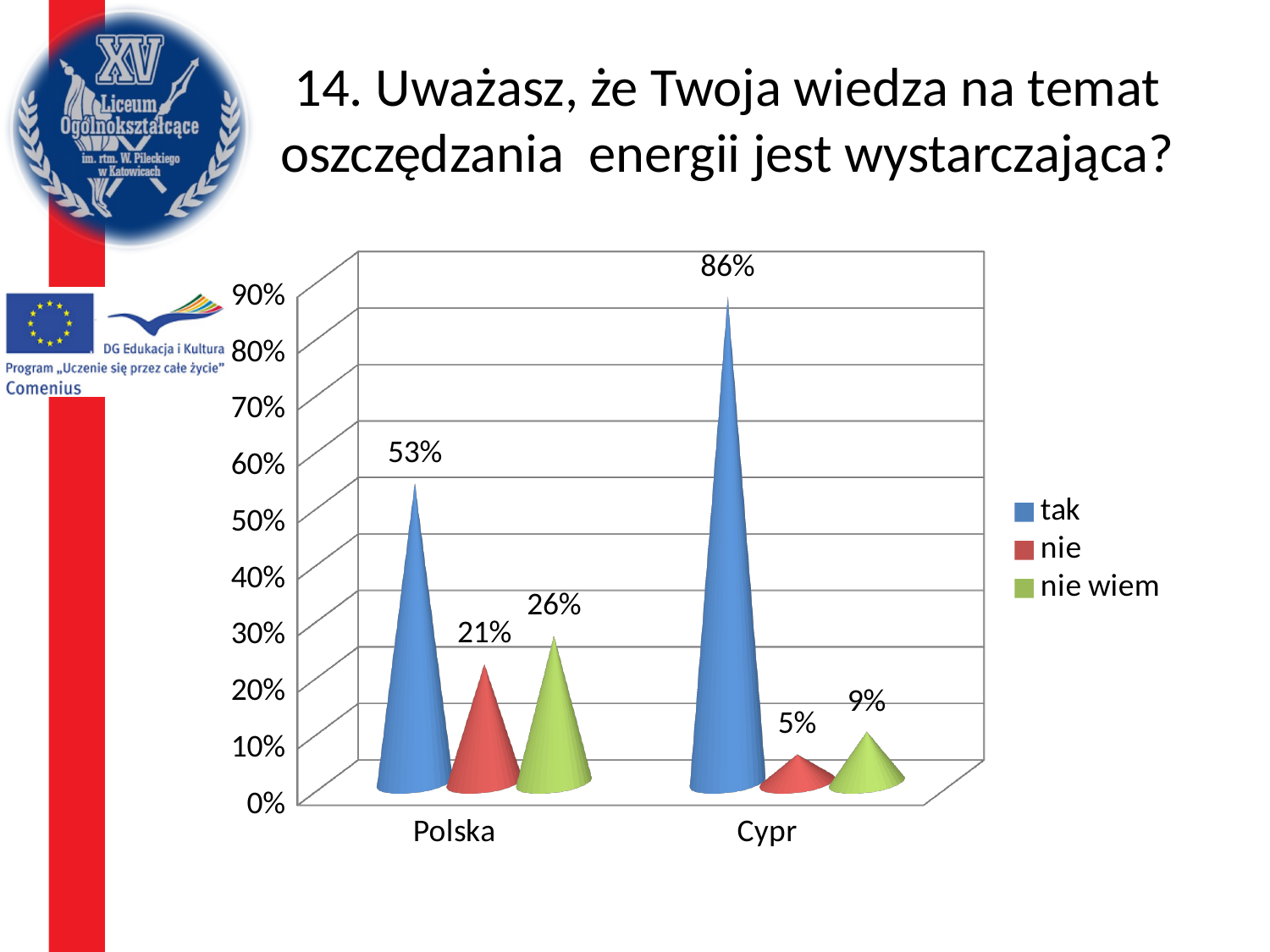
How many series does the legend list? 3 What is the value for "tak" for Cypr? 86% How many countries are shown on the x axis? 2 What is the difference between the "tak" values for Cypr and Polska? 33% What is the value for "tak" for Polska? 53% Which is larger for Polska: "nie" or "nie wiem"? nie wiem Which series has the lowest value for Cypr? nie What colour represents the "nie wiem" series? green Is the value for "tak" for Cypr greater or less than 80%? greater What is the value for "nie" for Cypr? 5% Which country has the highest value for "tak"? Cypr What is the value for "nie wiem" for Polska? 26%